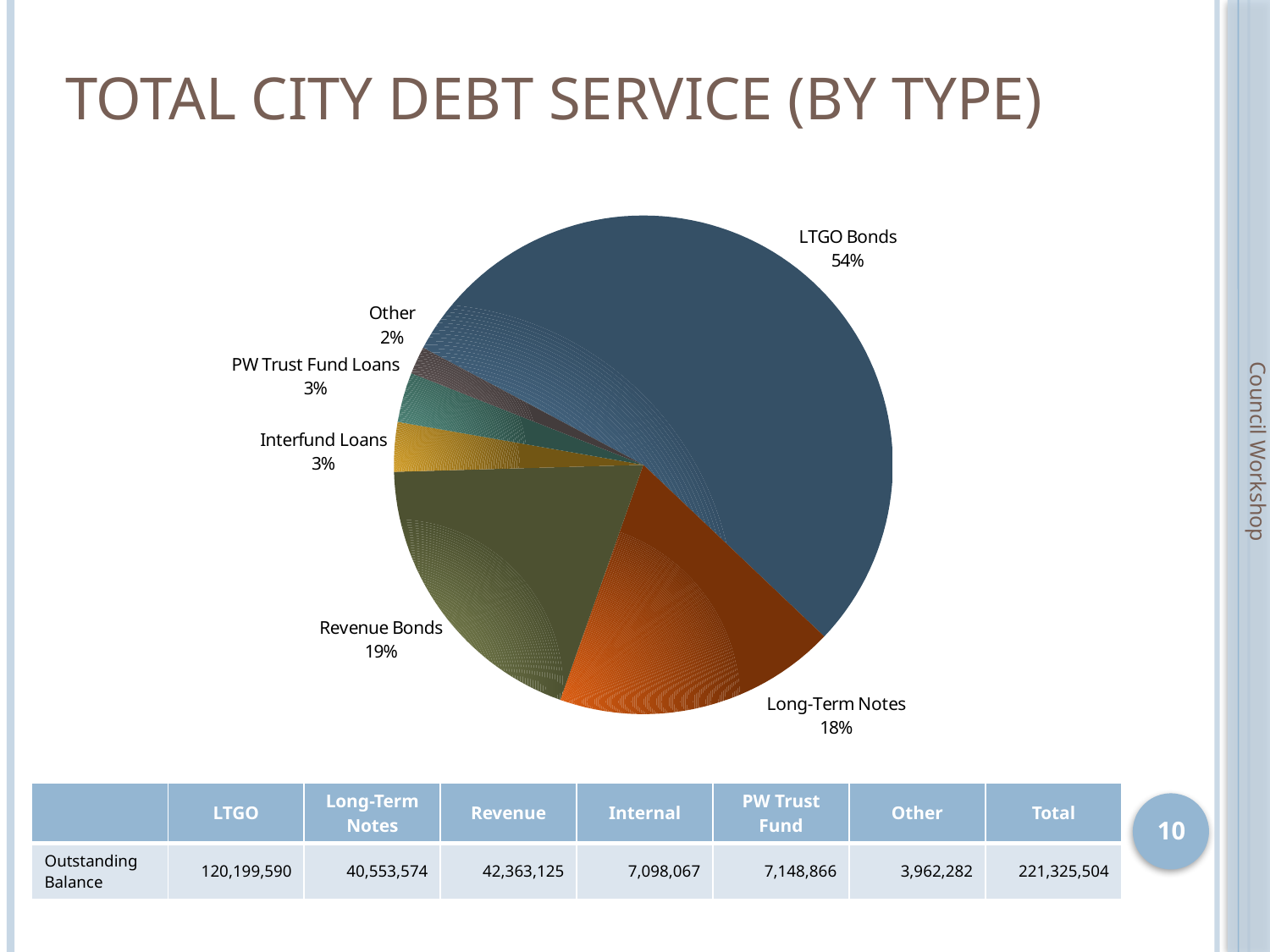
What share of the pie does LTGO Bonds represent? 54% What is the title of the slide containing the chart? TOTAL CITY DEBT SERVICE (BY TYPE) What type of chart is shown on the slide? Pie chart Which is larger, the share for LTGO Bonds or the share for Long-Term Notes? LTGO Bonds How many slices does the pie chart have? 6 What percentage is shown for Revenue Bonds? 19% Which category has the smallest slice of the pie? Other What percentage is shown for Long-Term Notes? 18% Which category has the largest slice of the pie? LTGO Bonds What percentage is shown for Other? 2% What is the difference in percentage points between LTGO Bonds and Revenue Bonds? 35 What percentage is shown for Interfund Loans? 3%